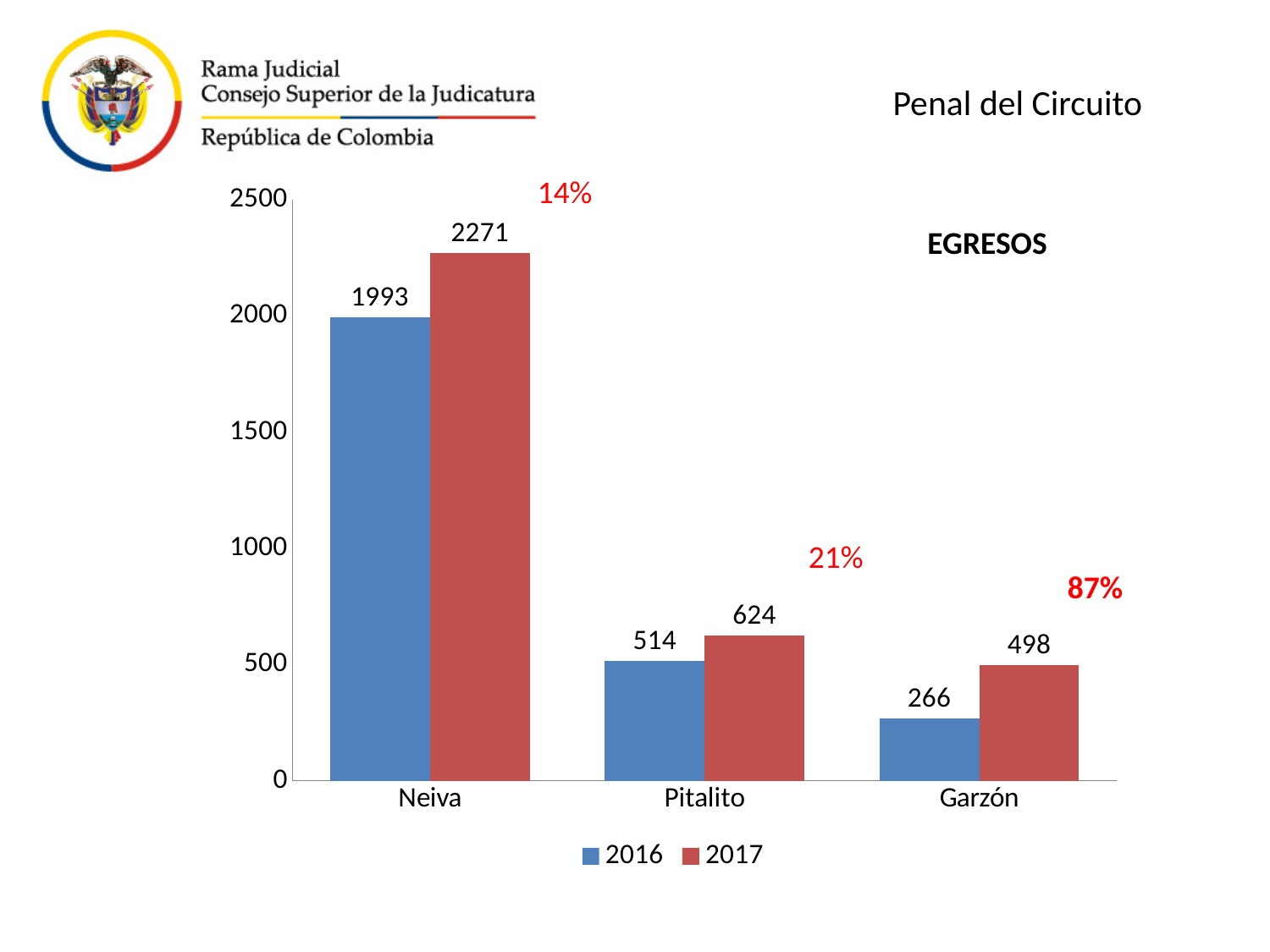
What is the 2017 value for Garzón? 498 What is the 2017 value for Pitalito? 624 Which category has the lowest 2016 value? Garzón What is the difference between the 2017 and 2016 values for Neiva? 278 How many series does the legend list? 2 Is the 2016 value for Garzón greater or less than 500? less Which category has the highest 2017 value? Neiva How many categories are shown on the x axis? 3 What percentage change is annotated in red above the Garzón bars? 87% What kind of chart is shown on the slide? bar chart What is the 2016 value for Neiva? 1993 Which is larger for Pitalito, the 2016 value or the 2017 value? 2017